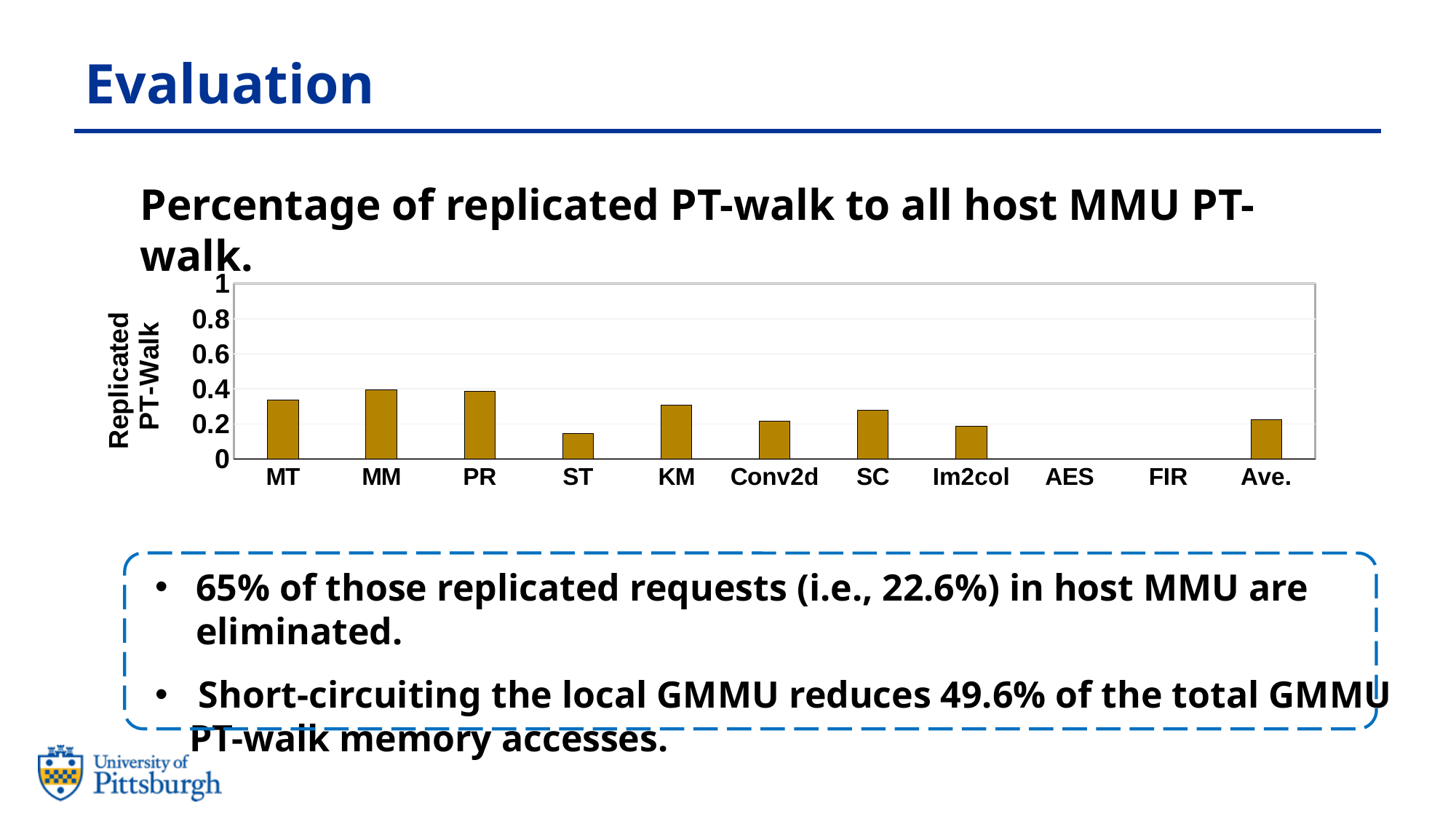
What is the label of the y axis of the chart? Replicated PT-Walk Which is larger, the value for MM or the value for Im2col? MM What kind of chart is shown on the slide? bar chart Is the value for MM greater or less than 0.6? less Which is larger, the value for KM or the value for Conv2d? KM How many categories are shown on the x axis of the chart? 11 Which is larger, the value for MT or the value for ST? MT Is the value for SC greater or less than 0.4? less Is the value for ST greater or less than 0.2? less What is the highest tick value shown on the y axis of the chart? 1